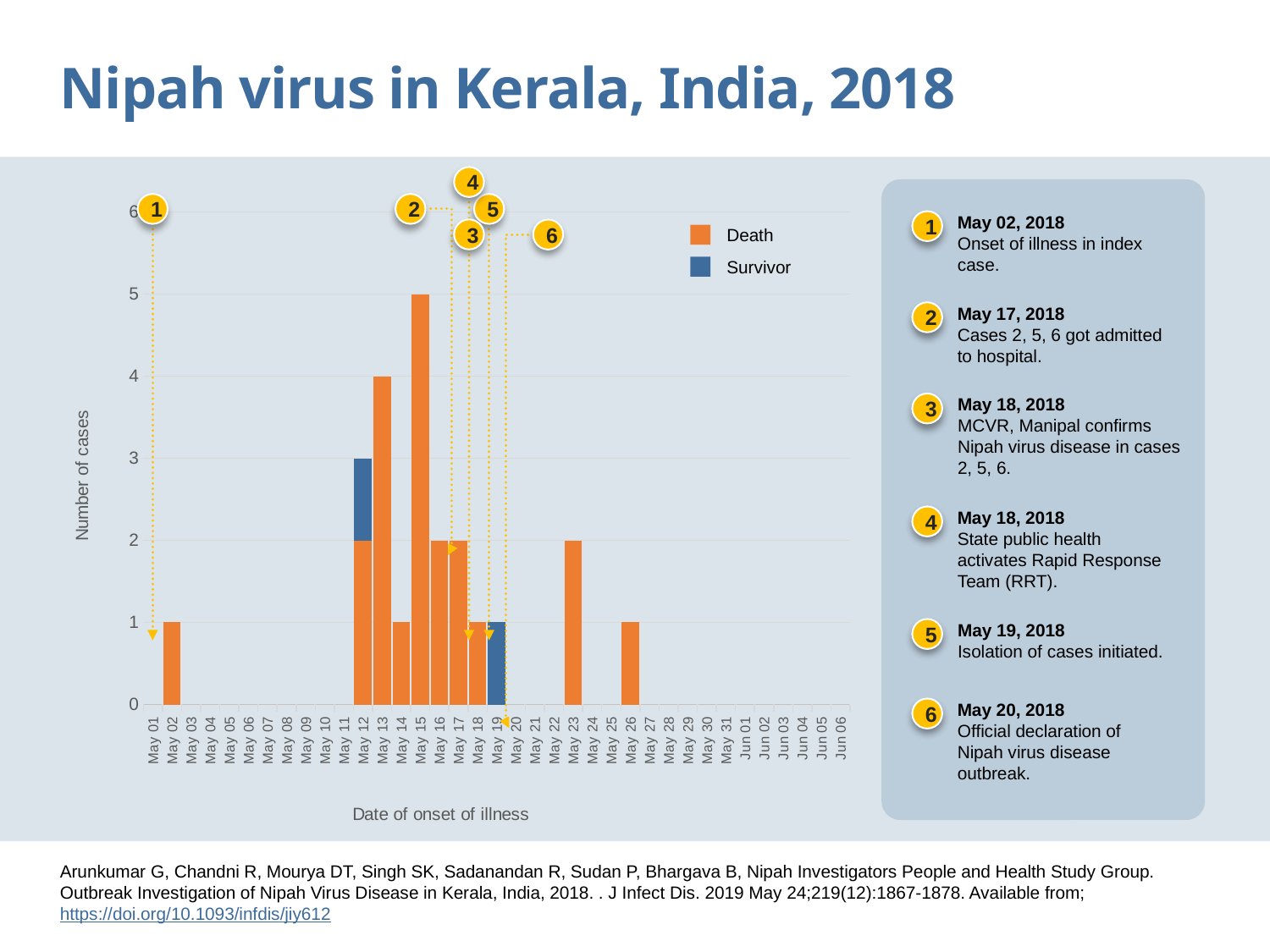
How many series does the chart legend list? 2 What is the difference in number of cases between May 15 and May 13? 1 How many deaths have a date of onset of May 13? 4 Which date of onset has the highest number of cases? May 15 Which date has more cases, May 13 or May 23? May 13 How many cases have a date of onset of May 15? 5 What kind of chart is shown on the slide? bar chart What are the two entries in the chart legend? Death, Survivor What is the title of the y axis? Number of cases How many dates on the x axis have at least one case plotted? 11 What is the total number of cases with onset on May 12? 3 How many survivors have a date of onset of May 12? 1